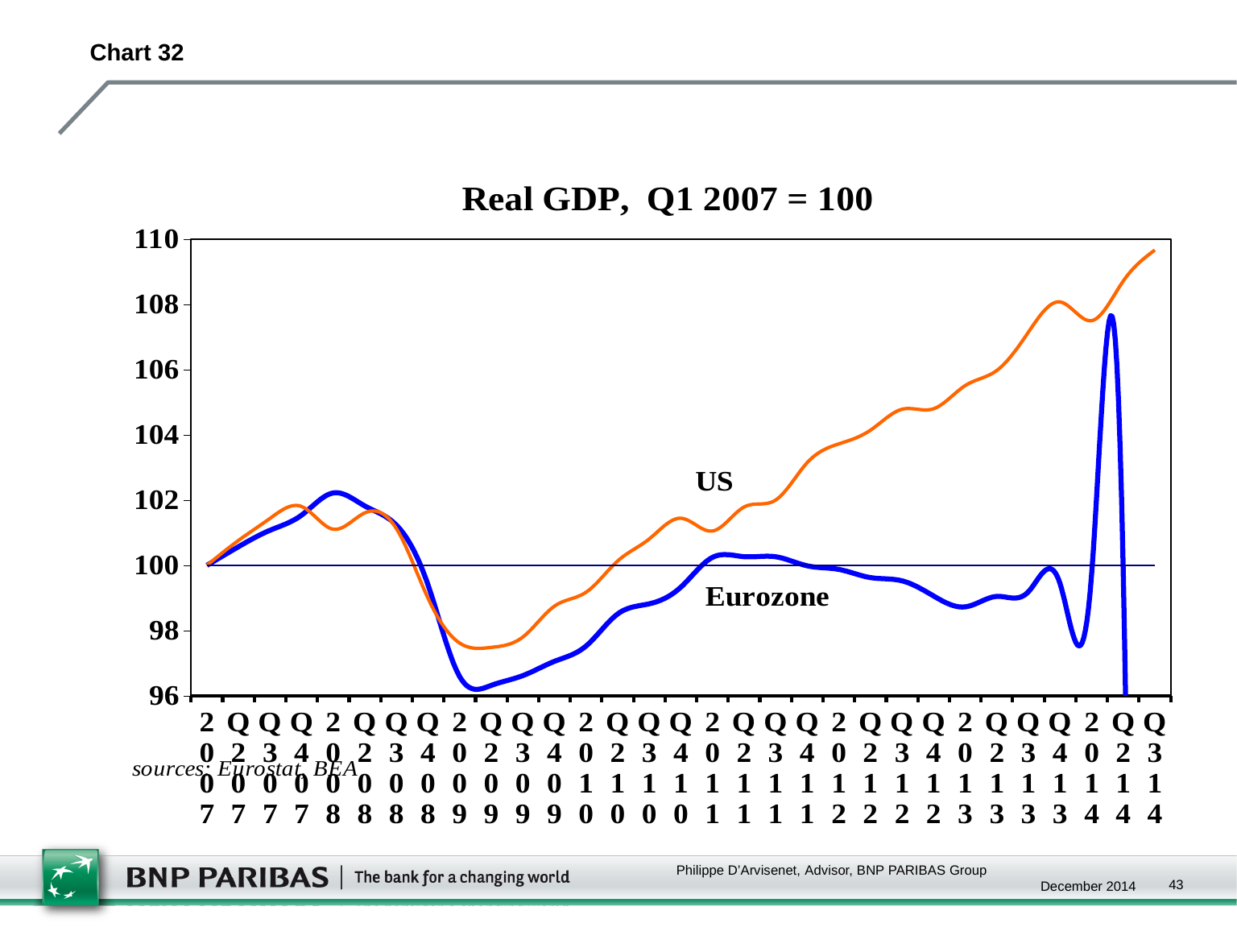
What colour is the line for the Eurozone series? blue What is the title of the chart? Real GDP, Q1 2007 = 100 Is the value for the US at Q3 2014 greater or less than 108? greater How many series are plotted on the chart? 3 Does the US series rise or fall from Q1 2010 to Q3 2014? rise What kind of chart is shown on the slide? line chart Is the value for the Eurozone at Q1 2009 greater or less than 98? less Is the value for the US at Q4 2010 greater or less than 100? greater How many quarters are shown along the x axis? 31 What is the value of the US series at Q1 2007? 100